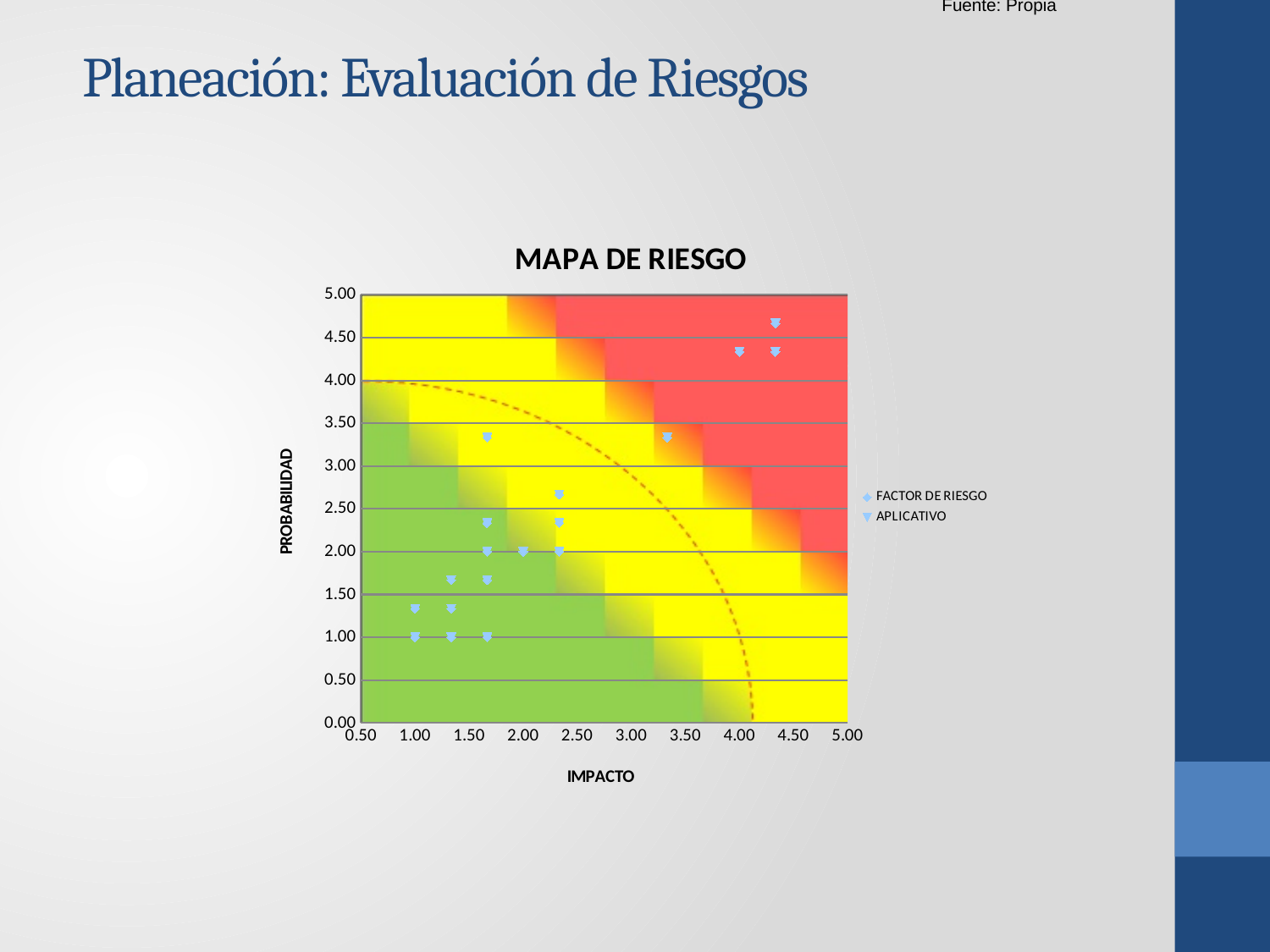
How many series does the chart's legend list? 2 Is the IMPACTO value of the leftmost plotted points greater or less than 1.50? less What is the title of the chart? MAPA DE RIESGO What kind of chart is shown on the slide? scatter chart Is the IMPACTO value of the rightmost plotted points greater or less than 4.50? less Is the PROBABILIDAD value of the highest plotted point greater or less than 4.00? greater What are the two entries in the chart's legend? FACTOR DE RIESGO and APLICATIVO